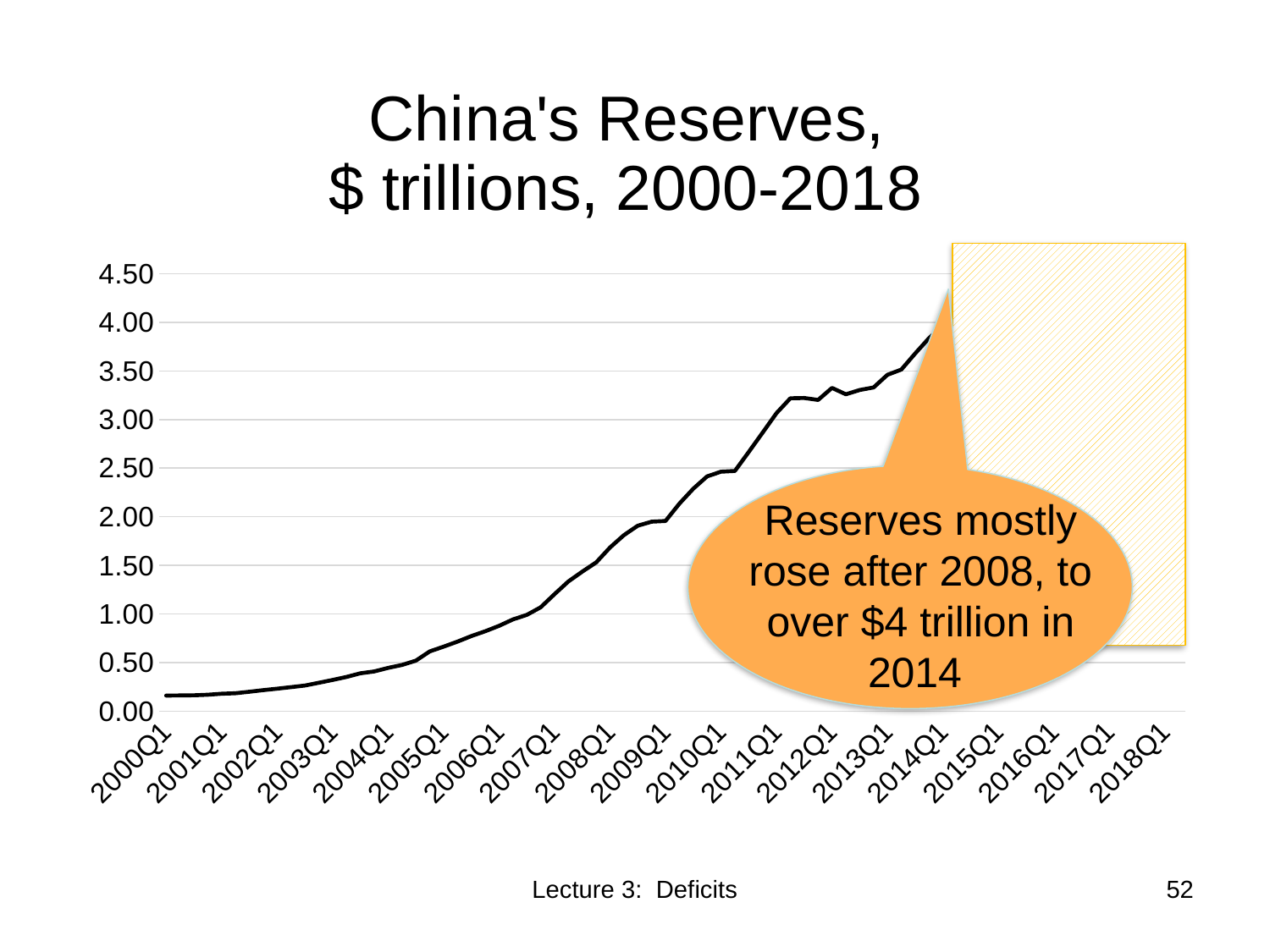
How many year labels are shown on the x axis? 19 Which is larger, the value for 2006Q1 or the value for 2011Q1? 2011Q1 What kind of chart is shown on the slide? line chart Is the value for 2012Q1 greater or less than 3.00? greater What does the callout on the chart say? Reserves mostly rose after 2008, to over $4 trillion in 2014 Is the value for 2013Q1 greater or less than 4.00? less Is the value for 2008Q1 greater or less than 1.00? greater Do China's reserves generally rise or fall from 2000Q1 to 2014Q1? rise What is the title of the chart? China's Reserves, $ trillions, 2000-2018